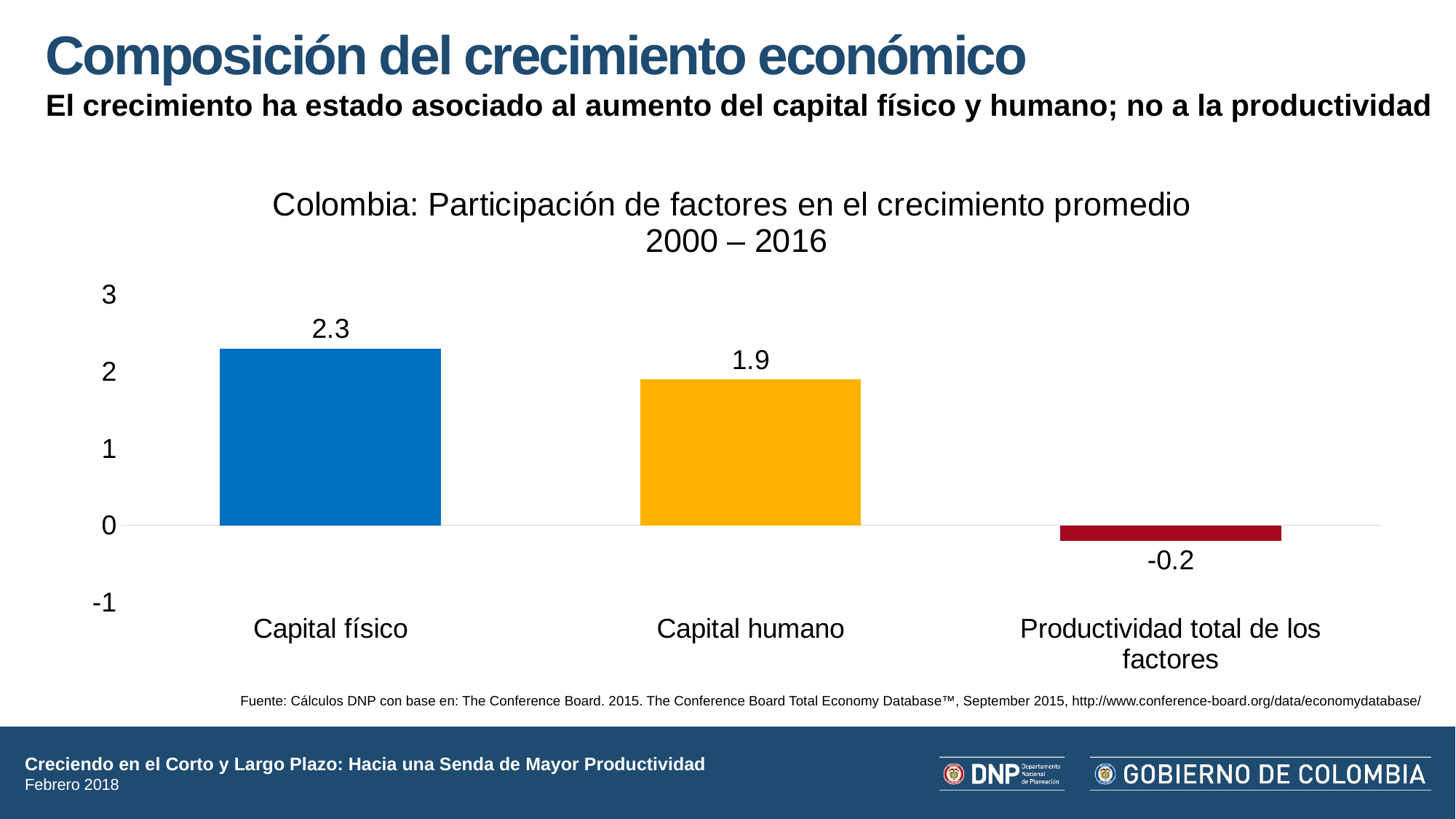
What is the value for Capital físico? 2.3 What is the title of the chart? Colombia: Participación de factores en el crecimiento promedio 2000 – 2016 What is the difference between the values for Capital físico and Capital humano? 0.4 Which category has the highest value? Capital físico How many categories are shown in the chart? 3 What colour is the bar for Capital humano? Orange What kind of chart is shown on the slide? Bar chart What is the value for Capital humano? 1.9 What is the value for Productividad total de los factores? -0.2 Is the value for Capital físico greater or less than 2? greater Which category has the lowest value? Productividad total de los factores Which is larger, the value for Capital humano or the value for Productividad total de los factores? Capital humano